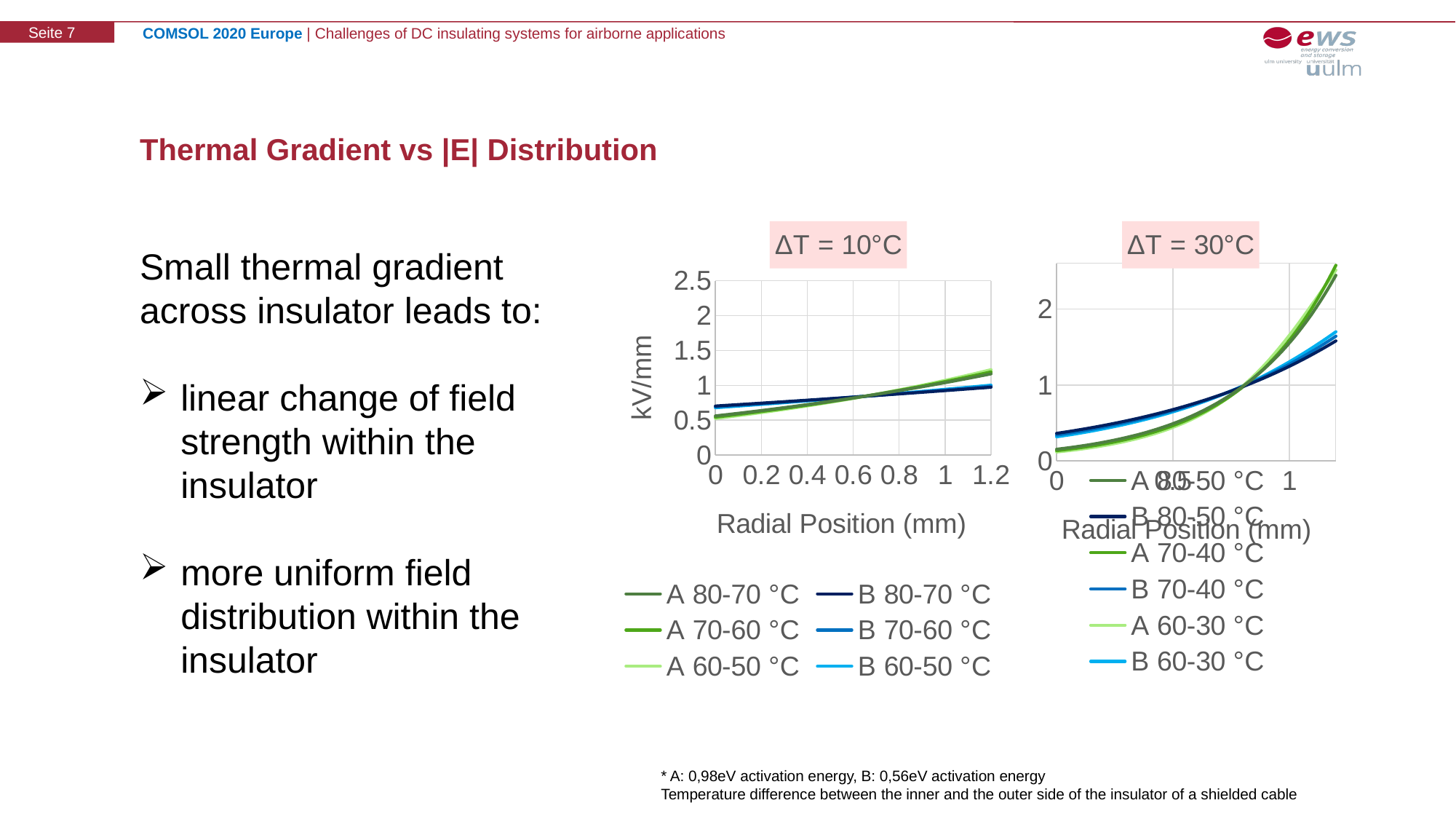
What is the y-axis label of the ΔT = 10°C chart? kV/mm What type of chart is the ΔT = 30°C chart? line chart In the ΔT = 30°C chart, is the value of the B 80-50 °C series at the right end of the x axis greater or less than 2? less In the ΔT = 30°C chart, do the values rise or fall as radial position increases? rise In the ΔT = 10°C chart, is the value of the B 80-70 °C series at radial position 0 mm greater or less than 0.5? greater In the ΔT = 10°C chart, is the value of the A 80-70 °C series at radial position 1.2 mm greater or less than 1? greater What type of chart is the ΔT = 10°C chart? line chart How many series does the legend of the ΔT = 30°C chart list? 6 In the ΔT = 10°C chart, do the values rise or fall as radial position increases? rise How many series does the legend of the ΔT = 10°C chart list? 6 In the ΔT = 30°C chart, at the right end of the x axis, do the A series or the B series reach higher values? A series